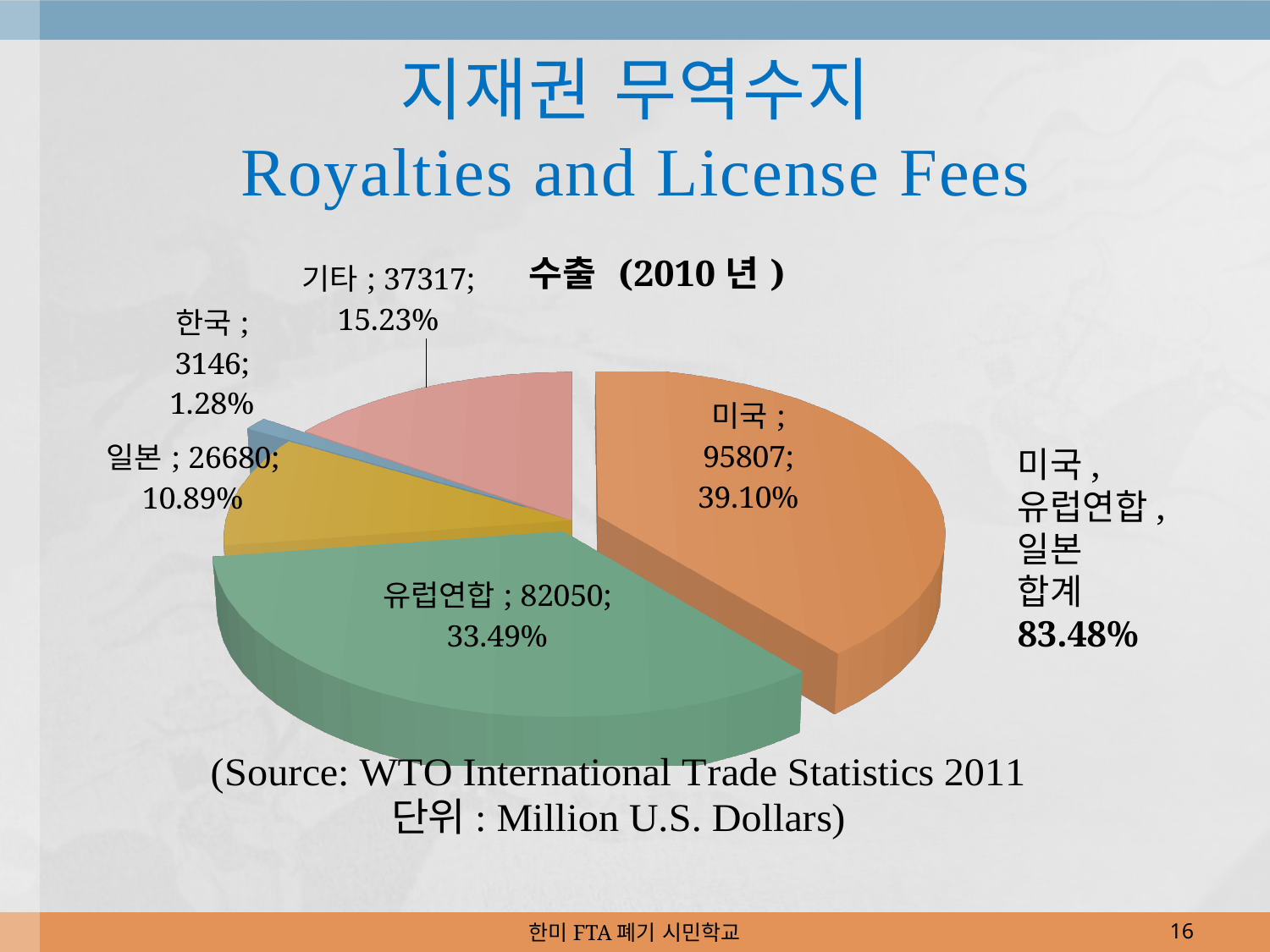
Which category has the smallest slice in the pie chart? 한국 What is the difference between the values for 미국 and 유럽연합? 13757 What is the value for 일본 in the pie chart? 26680 Which category has the largest slice in the pie chart? 미국 What is the value for 유럽연합 in the pie chart? 82050 How many slices does the pie chart have? 5 What share of the pie does 일본 represent? 10.89% Which is larger, the value for 기타 or the value for 일본? 기타 What is the value for 미국 in the pie chart? 95807 What kind of chart is shown on the slide? pie chart What share of the pie does 기타 represent? 15.23% What is the value for 한국 in the pie chart? 3146